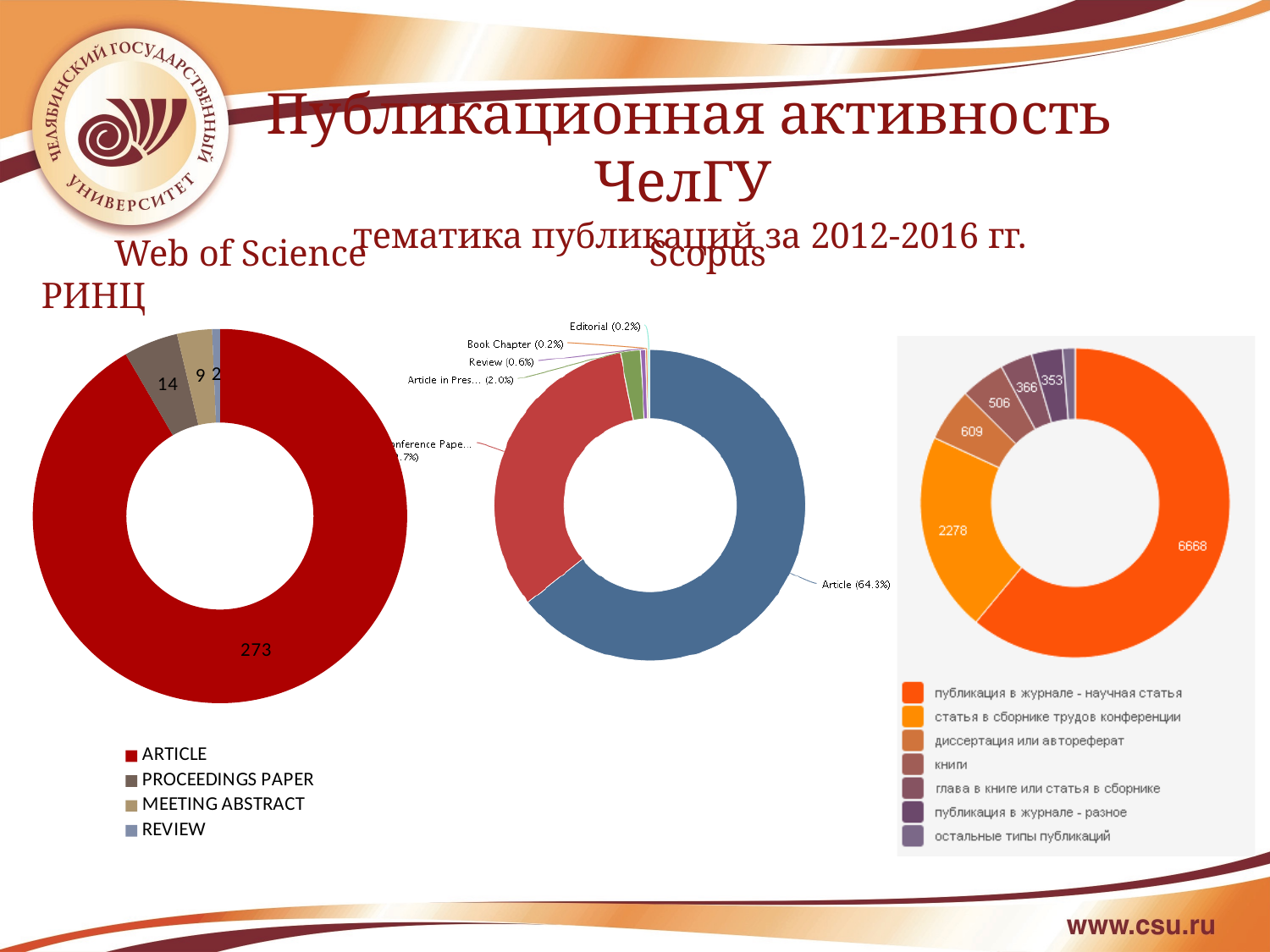
On the Scopus chart, what share does Book Chapter have? 0.2% On the Web of Science chart, how many entries does the legend list? 4 What kind of chart is the Web of Science chart? Donut (pie) chart On the РИНЦ chart, what is the value for the largest slice (публикация в журнале - научная статья)? 6668 On the Web of Science chart, what is the value for PROCEEDINGS PAPER? 14 On the Scopus chart, what share does Review have? 0.6% On the Scopus chart, what share does Article have? 64.3% On the Scopus chart, which is larger, Article in Press or Review? Article in Press On the Web of Science chart, what is the difference between ARTICLE and PROCEEDINGS PAPER? 259 On the РИНЦ chart, how many entries does the legend list? 7 On the Web of Science chart, what is the value for ARTICLE? 273 On the Web of Science chart, which category has the lowest value? REVIEW